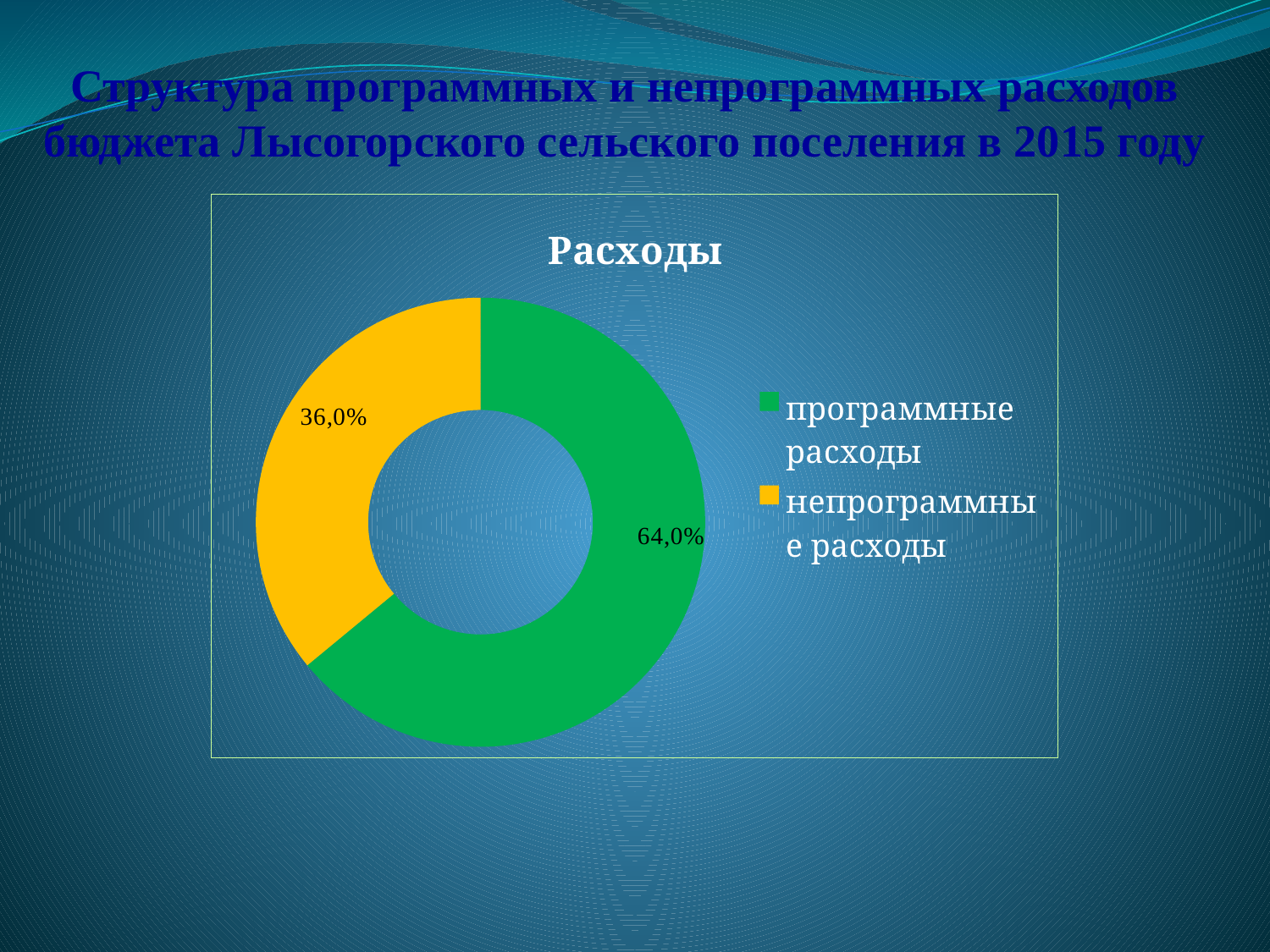
Which category has the smallest share of the chart? непрограммные расходы Which category has the largest share of the chart? программные расходы What share of the chart is labelled for непрограммные расходы? 36,0% What kind of chart is shown on the slide? doughnut (pie) chart Which is larger: the share for программные расходы or for непрограммные расходы? программные расходы What share of the chart is labelled for программные расходы? 64,0% How many entries does the legend list? 2 What is the difference in percentage points between программные расходы and непрограммные расходы? 28,0% What is the title of the chart? Расходы What colour represents непрограммные расходы in the chart? yellow How many categories does the chart show? 2 Is the share for программные расходы greater or less than 50%? greater